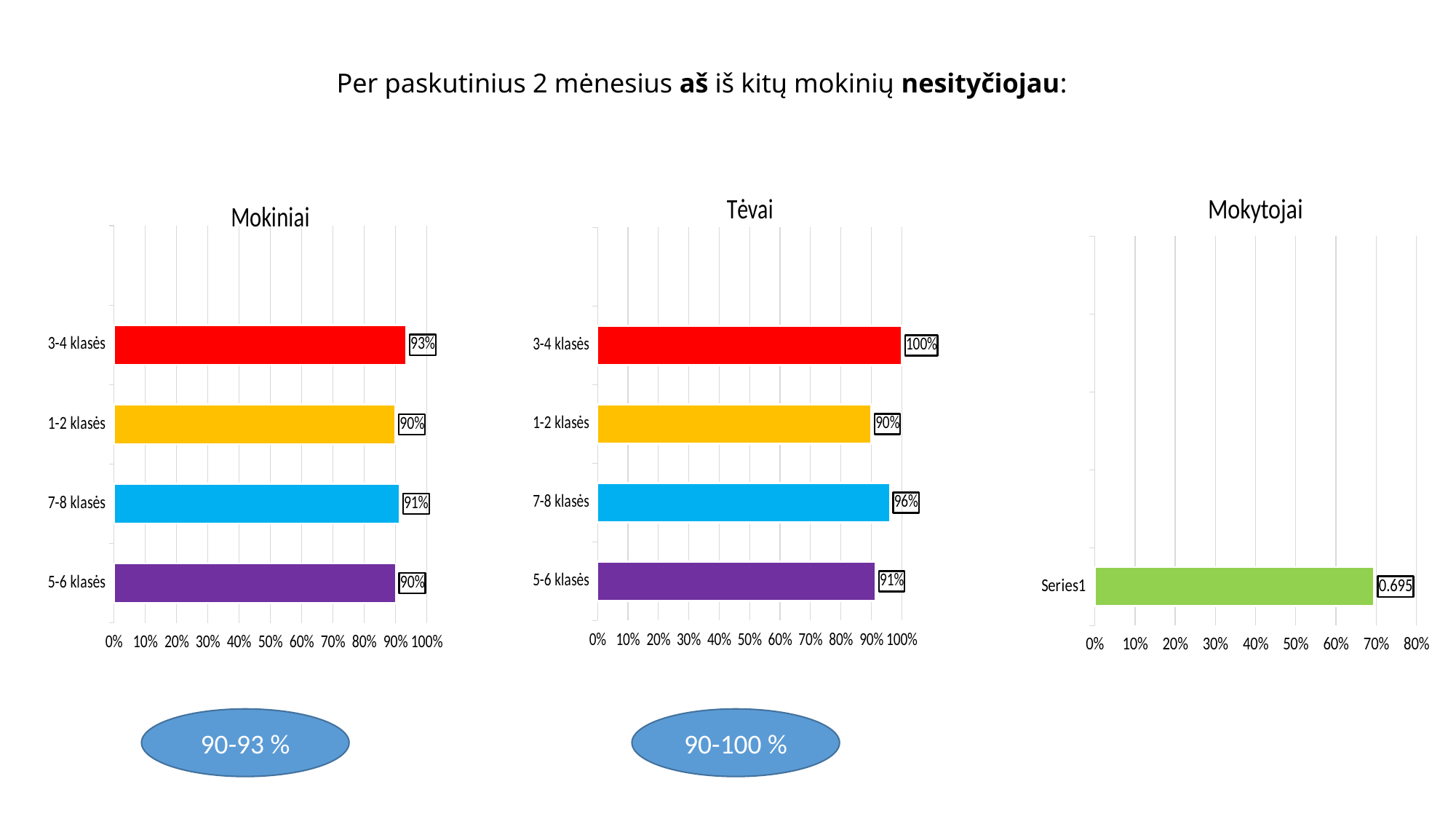
In the Tėvai chart, which category has the highest value? 3-4 klasės In the Mokiniai chart, what is the value for 3-4 klasės? 93% In the Mokytojai chart, is the value for Series1 greater or less than 60%? greater How many categories does the Mokiniai chart show? 4 In the Tėvai chart, what is the difference between the values for 3-4 klasės and 1-2 klasės? 10% In the Mokiniai chart, what colour is the bar for 5-6 klasės? purple In the Tėvai chart, which category has the lowest value? 1-2 klasės What kind of chart is the Tėvai chart? bar chart In the Mokytojai chart, what is the value shown for Series1? 0.695 In the Tėvai chart, what is the value for 7-8 klasės? 96% In the Tėvai chart, which is larger: the value for 7-8 klasės or the value for 5-6 klasės? 7-8 klasės In the Mokiniai chart, which category has the highest value? 3-4 klasės